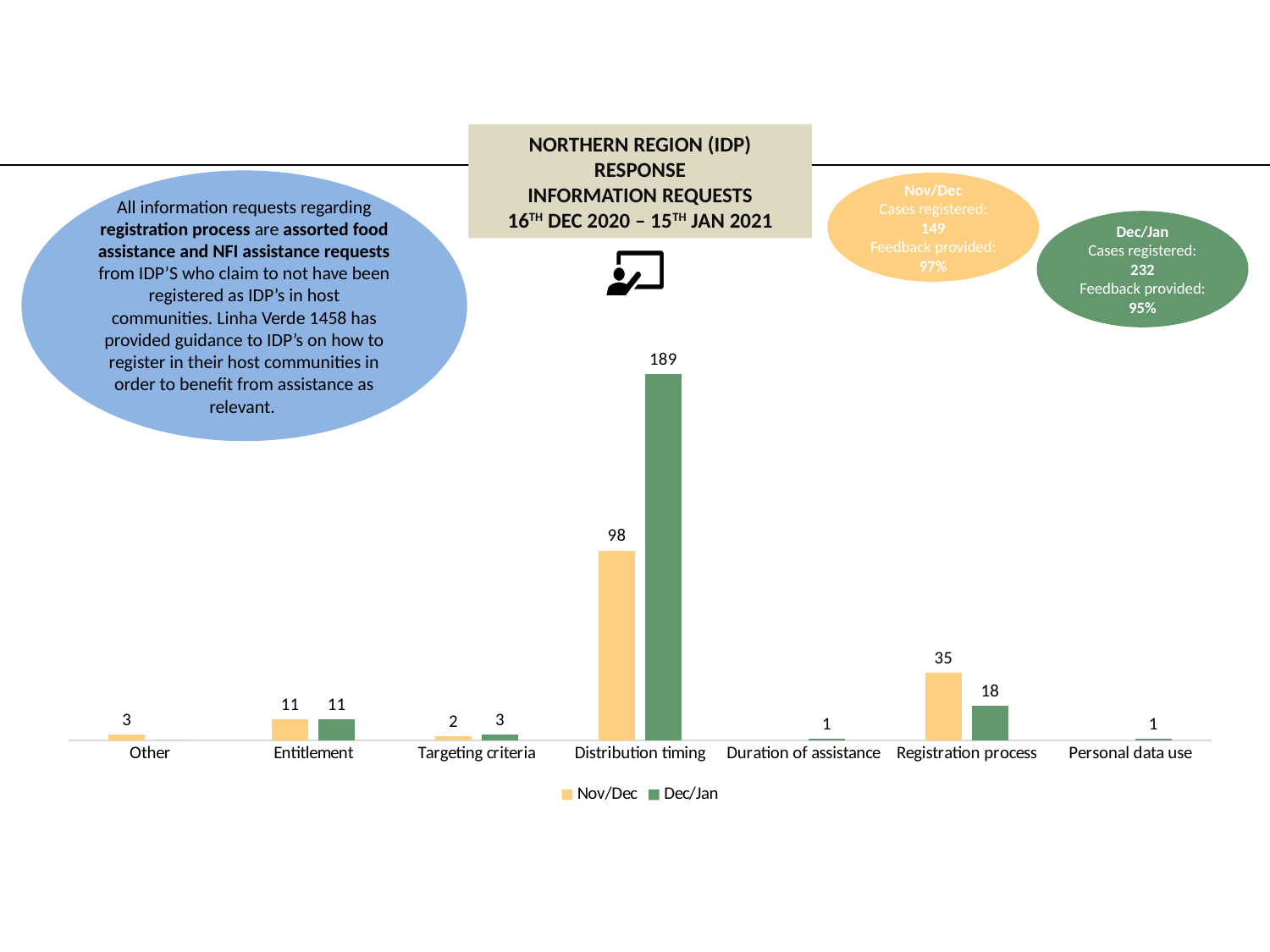
For Registration process, which series has the larger value, Nov/Dec or Dec/Jan? Nov/Dec Which category has the highest Dec/Jan value? Distribution timing What is the Nov/Dec value for Distribution timing? 98 What is the difference between the Nov/Dec and Dec/Jan values for Registration process? 17 What is the Nov/Dec value for Registration process? 35 What kind of chart is shown on the slide? Bar chart How many series does the legend list? 2 What is the Dec/Jan value for Targeting criteria? 3 Which category has the lowest Nov/Dec value among those with a labelled Nov/Dec bar? Targeting criteria What is the Dec/Jan value for Distribution timing? 189 What is the difference between the Dec/Jan and Nov/Dec values for Distribution timing? 91 How many categories are shown on the x axis? 7